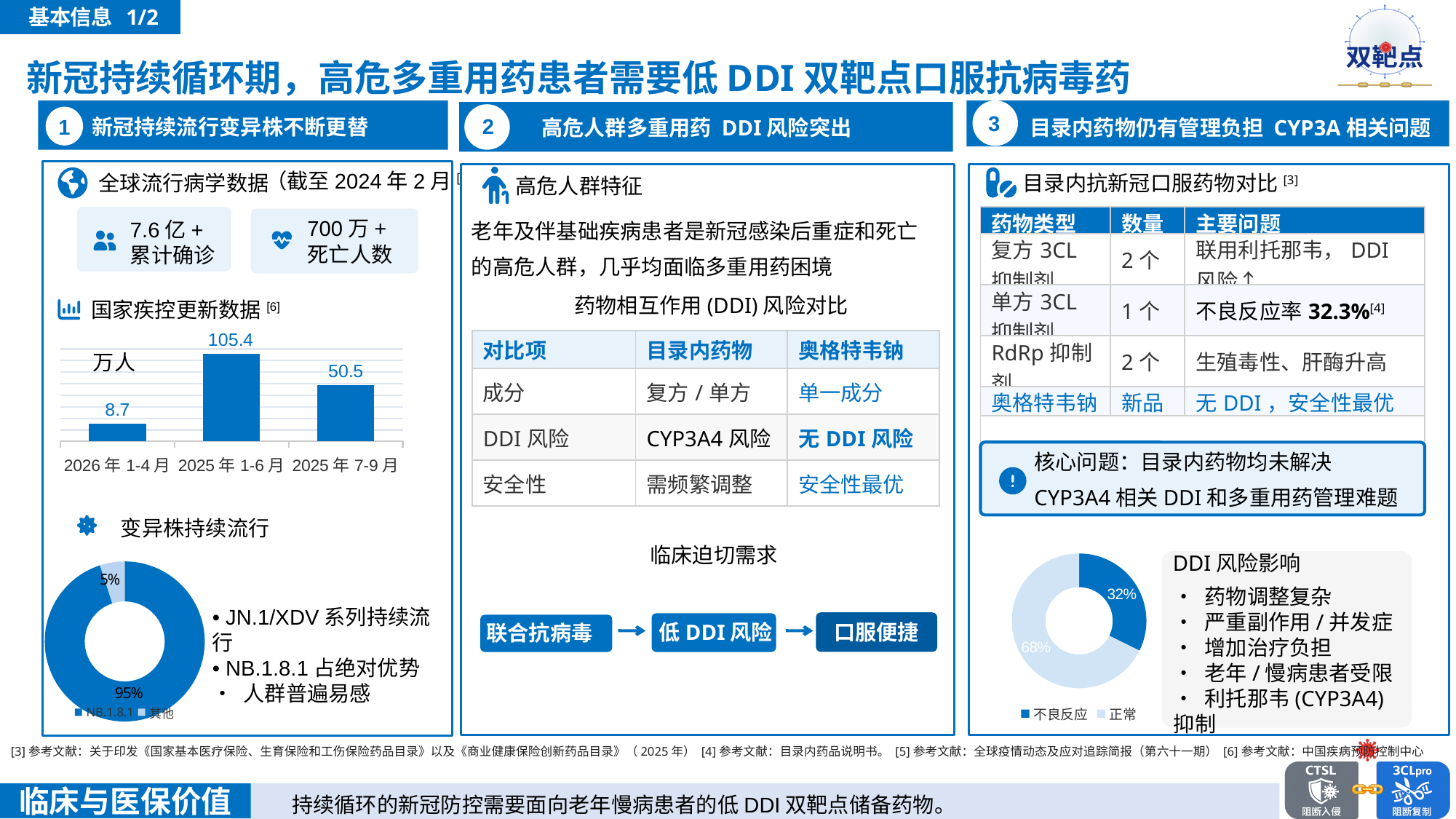
In the donut chart at the bottom right of the slide (next to DDI 风险影响), which slice is larger, 不良反应 or 正常? 正常 In the bar chart under 国家疾控更新数据, which category has the lowest value? 2026 年 1-4 月 In the bar chart under 国家疾控更新数据, what is the value for 2025 年 1-6 月? 105.4 In the bar chart under 国家疾控更新数据, what is the difference between the values for 2025 年 1-6 月 and 2025 年 7-9 月? 54.9 In the donut chart at the bottom right of the slide (next to DDI 风险影响), what share is labelled 不良反应? 32% In the bar chart under 国家疾控更新数据, how many bars are plotted? 3 What type of chart is shown under 国家疾控更新数据? Bar chart In the donut chart under 变异株持续流行, what share does 其他 have? 5% In the donut chart at the bottom right of the slide (next to DDI 风险影响), how many entries does the legend list? 2 In the bar chart under 国家疾控更新数据, which category has the highest value? 2025 年 1-6 月 In the bar chart under 国家疾控更新数据, what is the value for 2025 年 7-9 月? 50.5 In the donut chart under 变异株持续流行, what share does NB.1.8.1 have? 95%